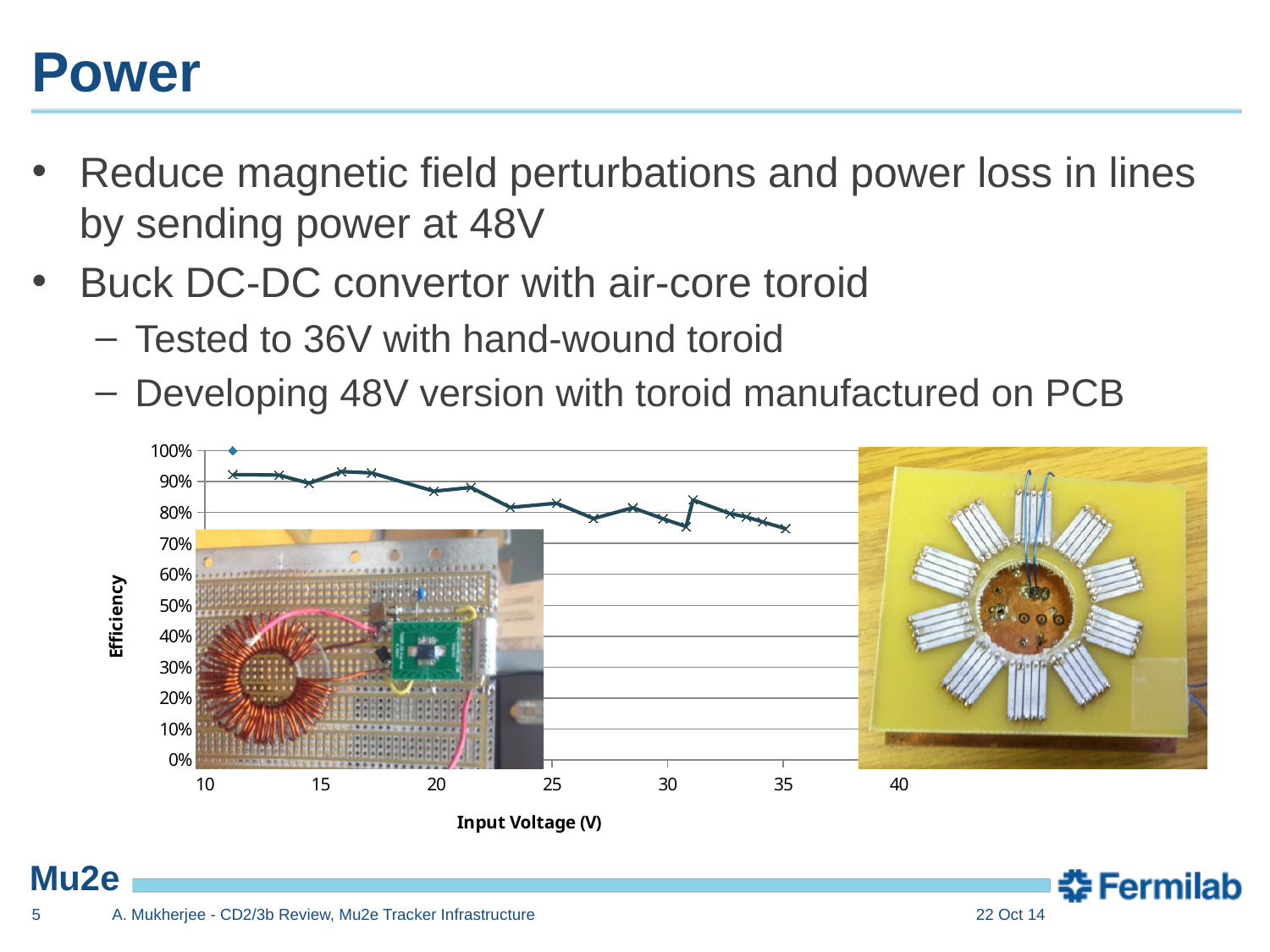
What is the title of the y axis of the chart? Efficiency Is the efficiency at an input voltage of 15 V greater or less than 80%? greater Is the efficiency at an input voltage of 35 V greater or less than 70%? greater Is the efficiency at an input voltage of 35 V greater or less than 80%? less What is the title of the x axis of the chart? Input Voltage (V) What kind of chart is shown on the slide? line chart Is the efficiency higher at an input voltage of 20 V or at 30 V? 20 V Is the efficiency higher at an input voltage of 15 V or at 35 V? 15 V Does efficiency generally rise or fall as input voltage increases along the x axis? fall